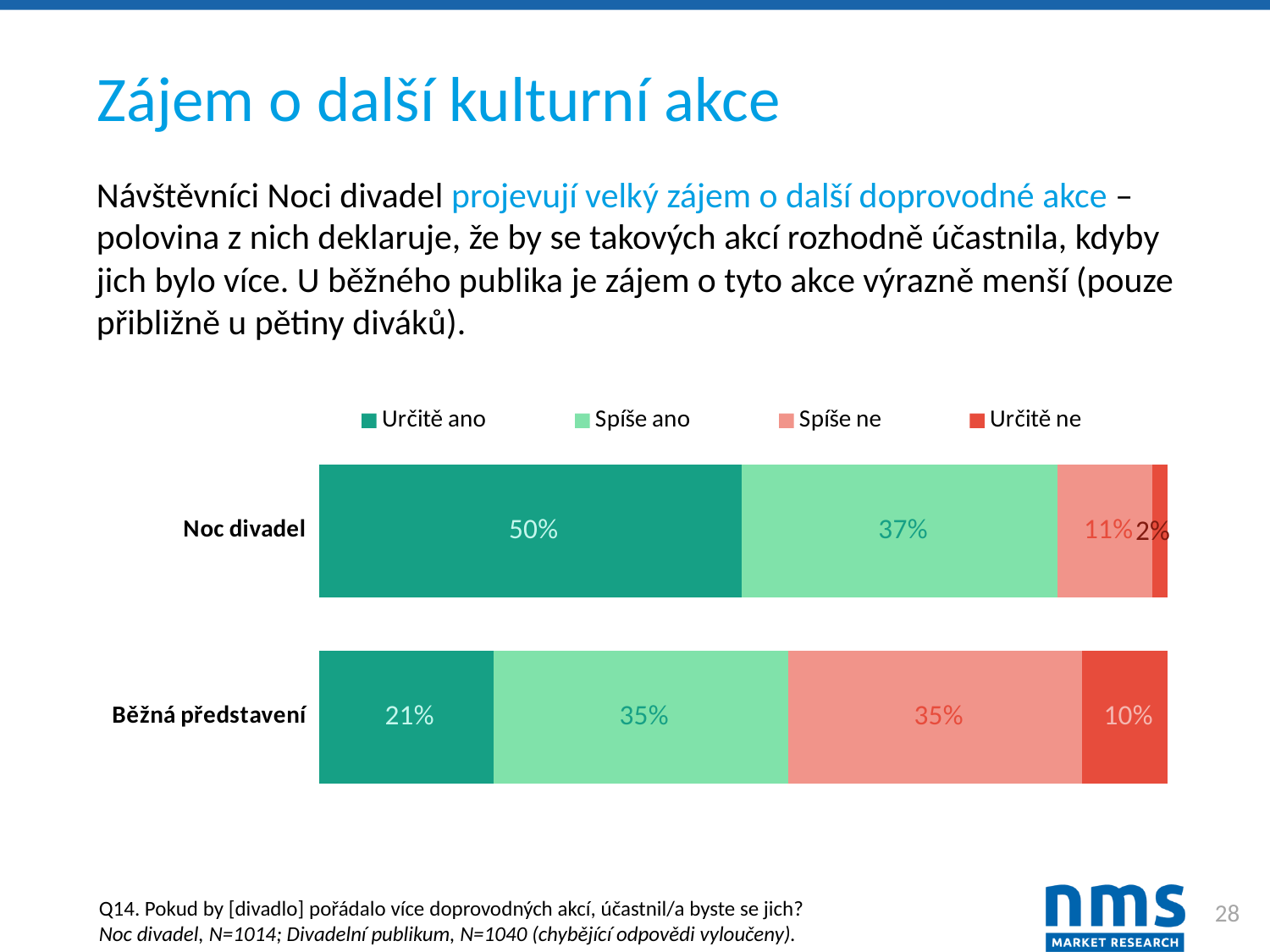
How many categories are shown on the chart? 2 What is the difference between the "Určitě ano" values for Noc divadel and Běžná představení? 29 percentage points How many series does the legend list? 4 What is the value for "Určitě ne" for Noc divadel? 2% What is the total of the "Určitě ano" and "Spíše ano" segments for Noc divadel? 87% What is the value for "Spíše ano" for Běžná představení? 35% What is the value for "Určitě ano" for Noc divadel? 50% Is the "Spíše ne" value larger for Noc divadel or for Běžná představení? Běžná představení Which category has the lower value for "Určitě ne"? Noc divadel What kind of chart is shown on the slide? Stacked bar chart What is the value for "Spíše ne" for Běžná představení? 35% Which category has the higher value for "Určitě ano"? Noc divadel